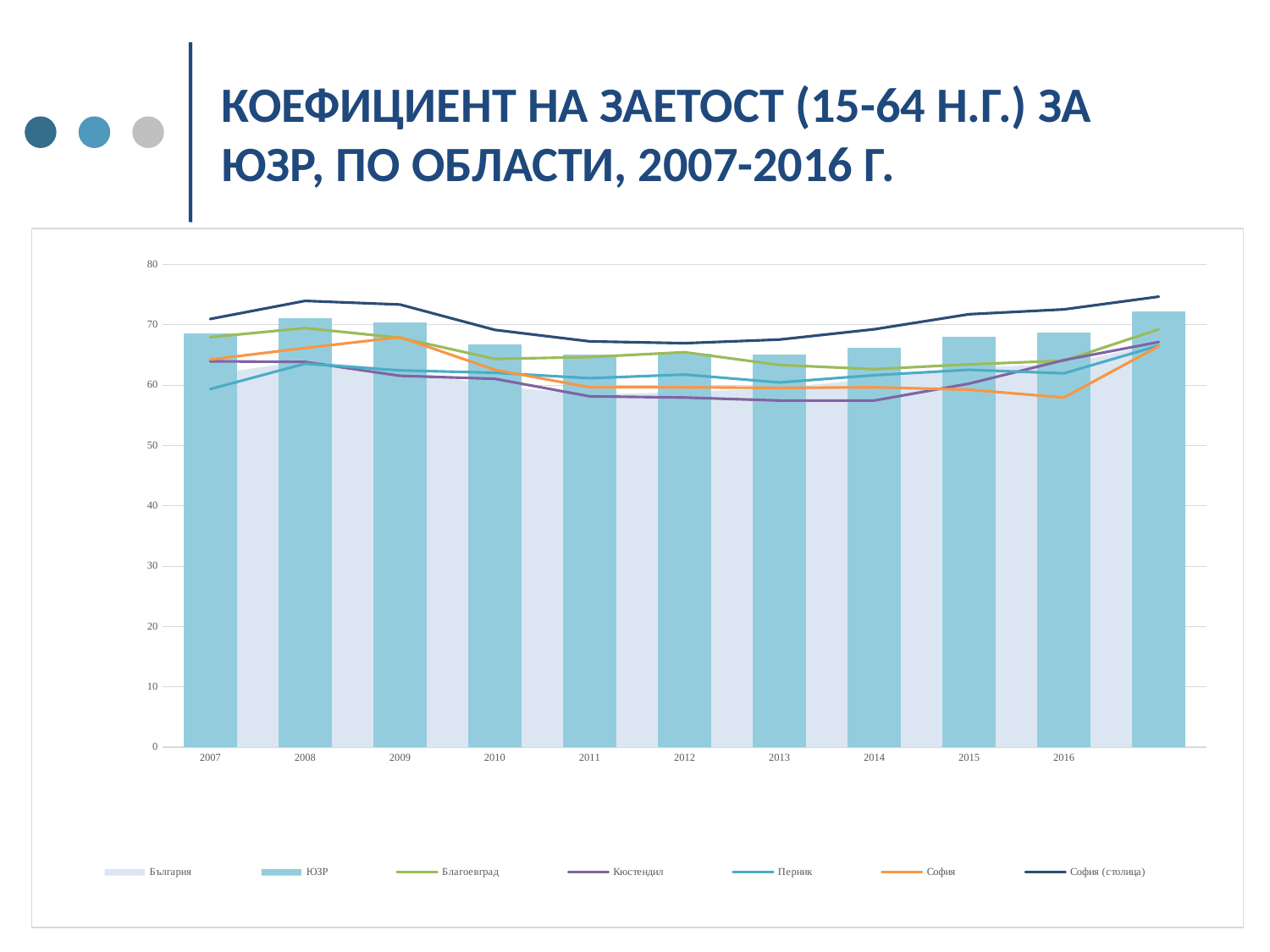
Which two series are plotted as bars rather than lines? България and ЮЗР Is the value for Благоевград in 2010 greater or less than 60? greater Does the Кюстендил line rise or fall from 2008 to 2012? fall Which series is shown as the dark navy line at the top of the chart? София (столица) Is the value for Кюстендил in 2012 greater or less than 60? less Is the value for София (столица) in 2008 greater or less than 70? greater Does the София (столица) line rise or fall from 2012 to 2016? rise What kind of chart is shown on the slide? A combined bar and line chart Which series has the highest values throughout the whole period? София (столица) How many series does the legend list? 7